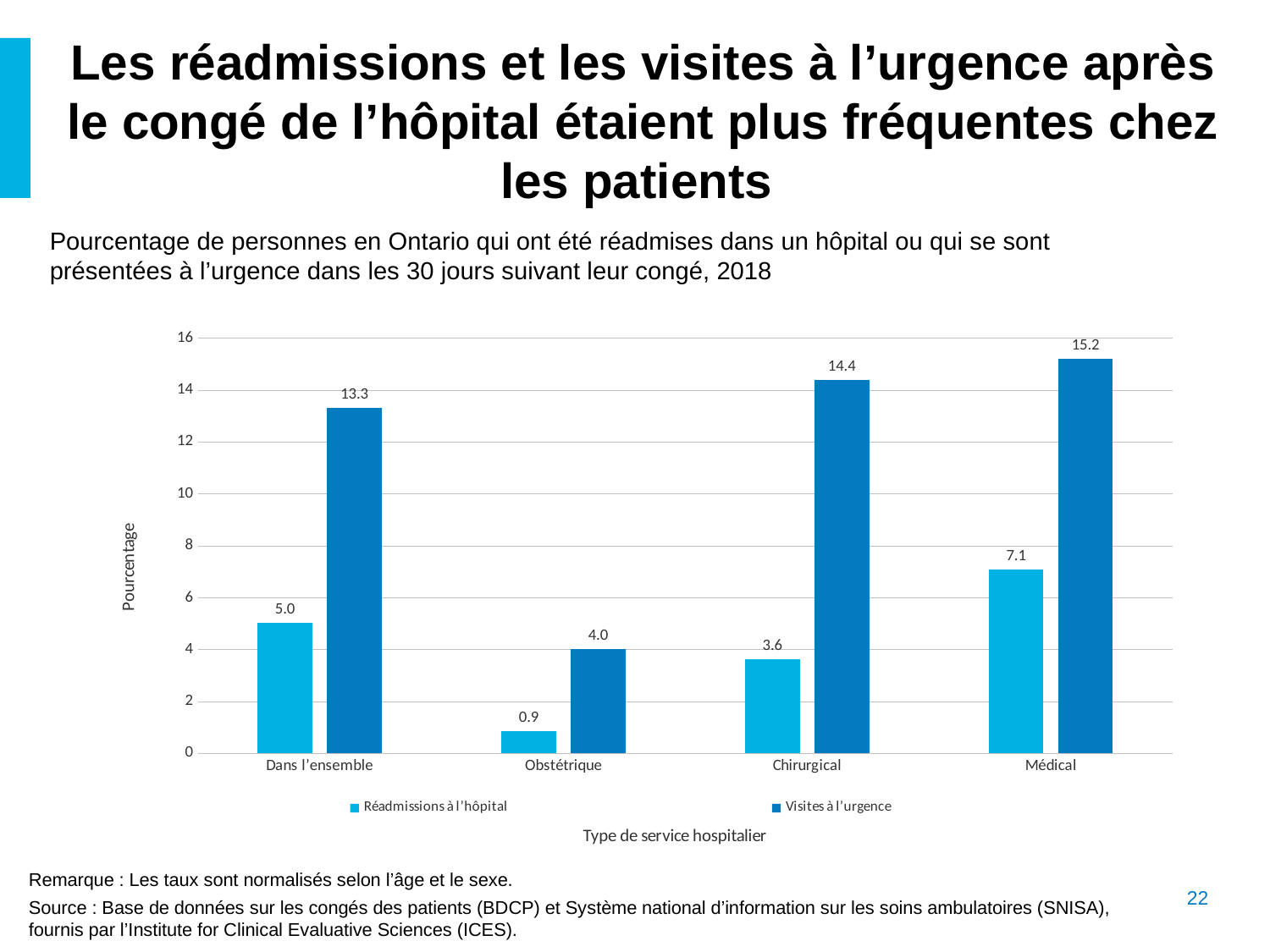
Which is larger: Réadmissions à l'hôpital for Médical or Réadmissions à l'hôpital for Dans l'ensemble? Médical Is the value for Visites à l'urgence in the Chirurgical category greater or less than 14? greater What is the value for Réadmissions à l'hôpital in the Dans l'ensemble category? 5.0 What is the value for Réadmissions à l'hôpital in the Médical category? 7.1 Which category has the highest value for Visites à l'urgence? Médical What is the value for Visites à l'urgence in the Obstétrique category? 4.0 What is the difference between Visites à l'urgence and Réadmissions à l'hôpital in the Chirurgical category? 10.8 How many categories are shown on the x axis? 4 Which category has the lowest value for Réadmissions à l'hôpital? Obstétrique What kind of chart is shown on the slide? Bar chart What is the label of the y axis? Pourcentage How many series does the legend list? 2